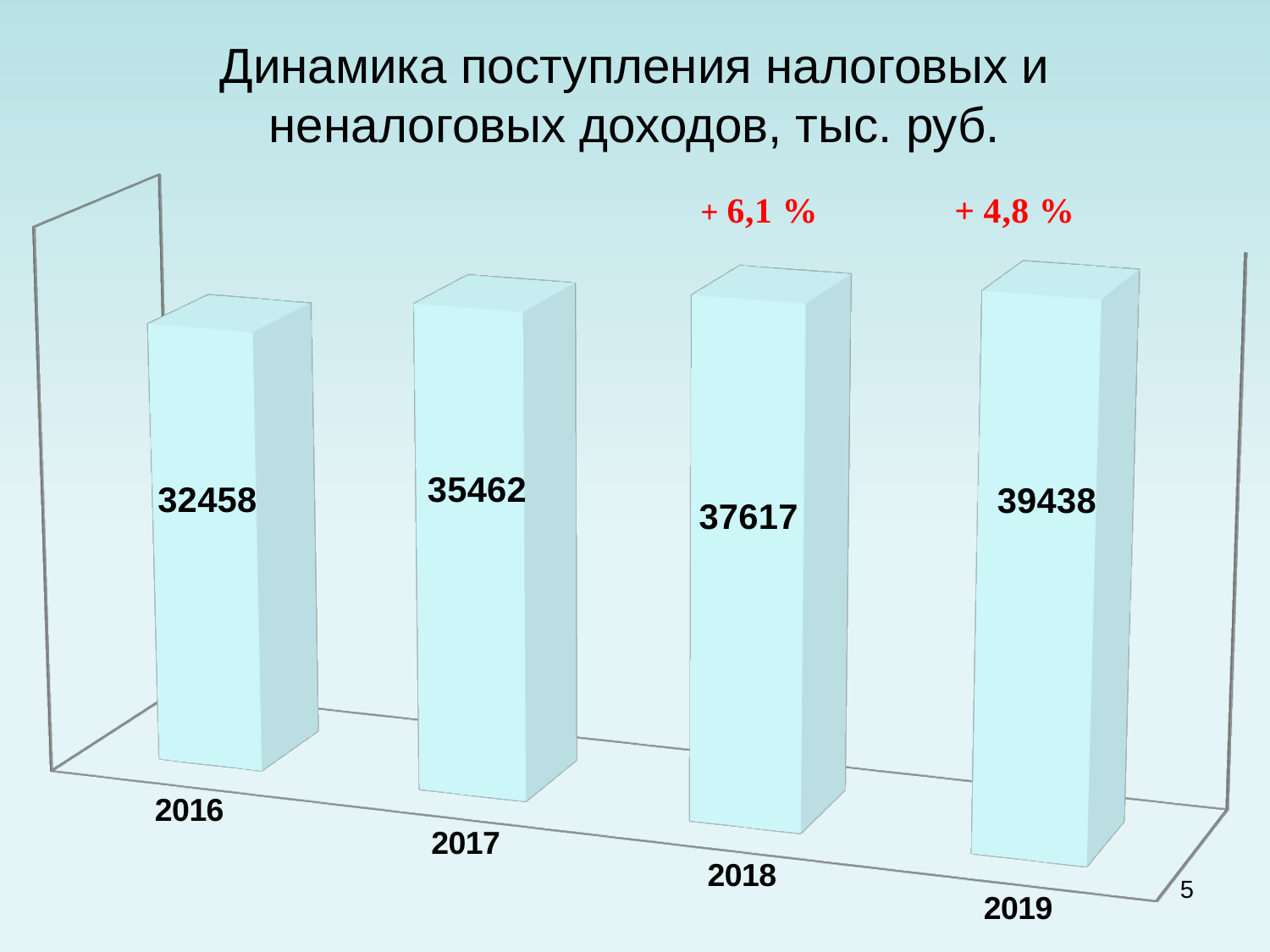
Which year has the highest value? 2019 What is the difference between the values for 2019 and 2016? 6980 What is the value for 2016? 32458 Which is larger, the value for 2017 or the value for 2018? 2018 What is the value for 2019? 39438 What is the difference between the values for 2018 and 2017? 2155 What is the value for 2017? 35462 Which year has the lowest value? 2016 How many years are shown on the chart? 4 Do the values rise or fall from 2016 to 2019? rise What is the value for 2018? 37617 What kind of chart is shown on the slide? bar chart